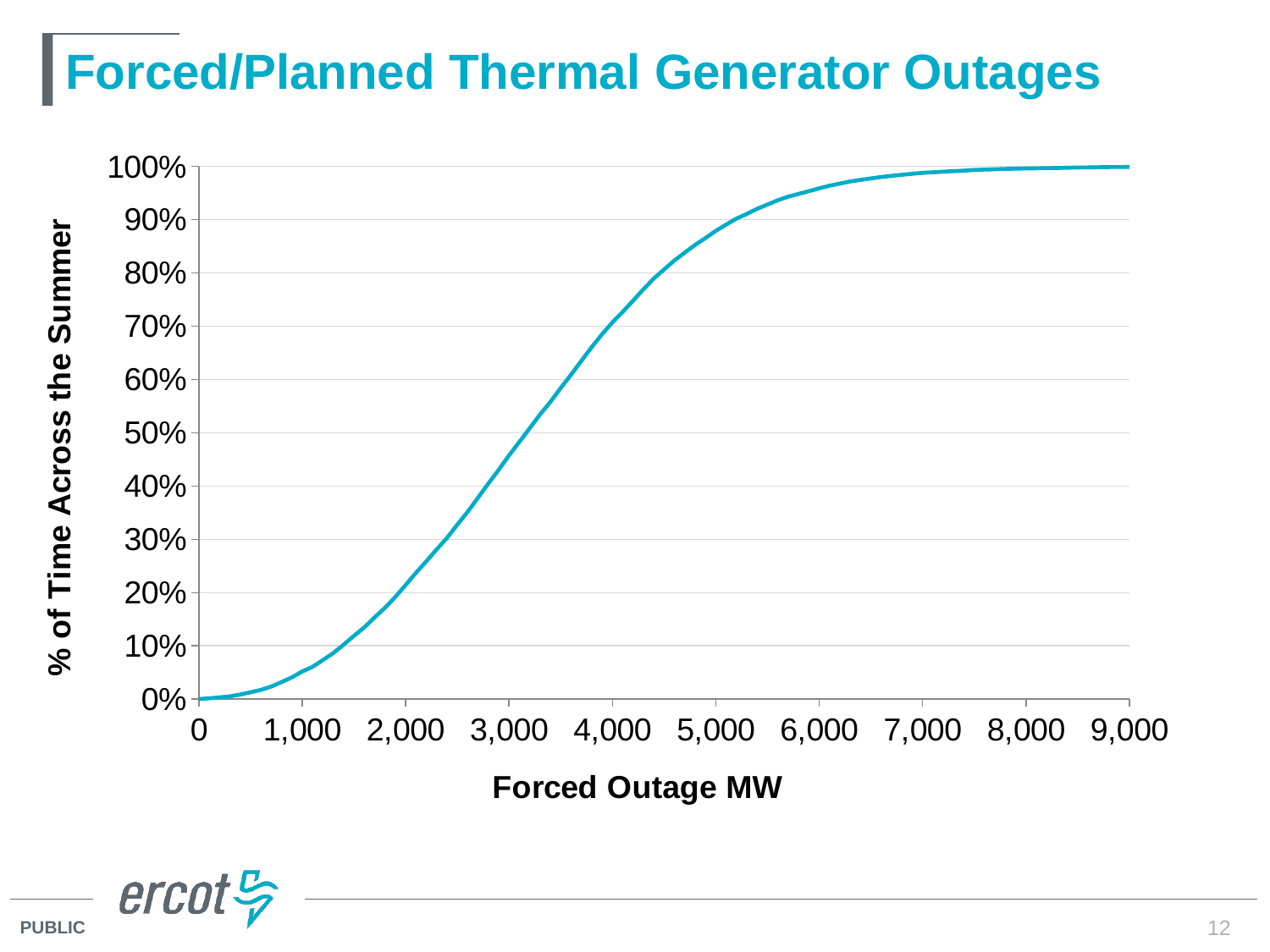
Is the value at 2,000 Forced Outage MW greater or less than 30%? less Is the value at 5,000 Forced Outage MW greater or less than 80%? greater Is the value at 4,000 Forced Outage MW greater or less than 60%? greater What is the title of the chart? Forced/Planned Thermal Generator Outages What is the label of the x axis? Forced Outage MW Do the values rise or fall as Forced Outage MW increases along the x axis? rise What kind of chart is shown on the slide? line chart